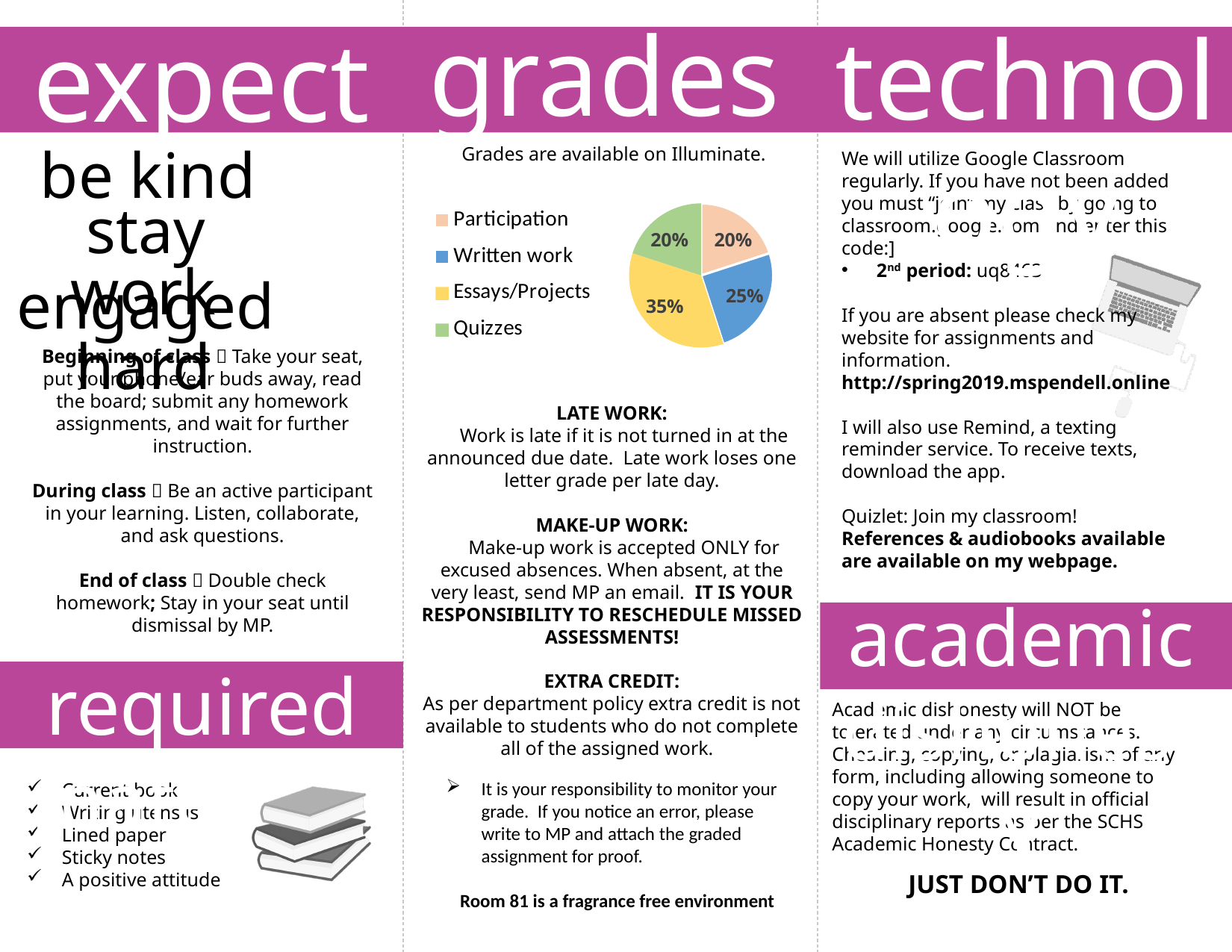
Which category has the largest slice in the pie chart? Essays/Projects How many slices does the pie chart have? 4 What percentage of the grade does Participation account for in the pie chart? 20% How many categories does the legend of the pie chart list? 4 What percentage of the grade does Quizzes account for in the pie chart? 20% What is the combined share of Participation and Quizzes in the pie chart? 40% What type of chart is shown in the grades section of the slide? pie chart What colour represents Essays/Projects in the pie chart? yellow Which is larger in the pie chart, Written work or Participation? Written work What is the difference in percentage points between Essays/Projects and Written work in the pie chart? 10 What percentage of the grade does Essays/Projects account for in the pie chart? 35% What percentage of the grade does Written work account for in the pie chart? 25%